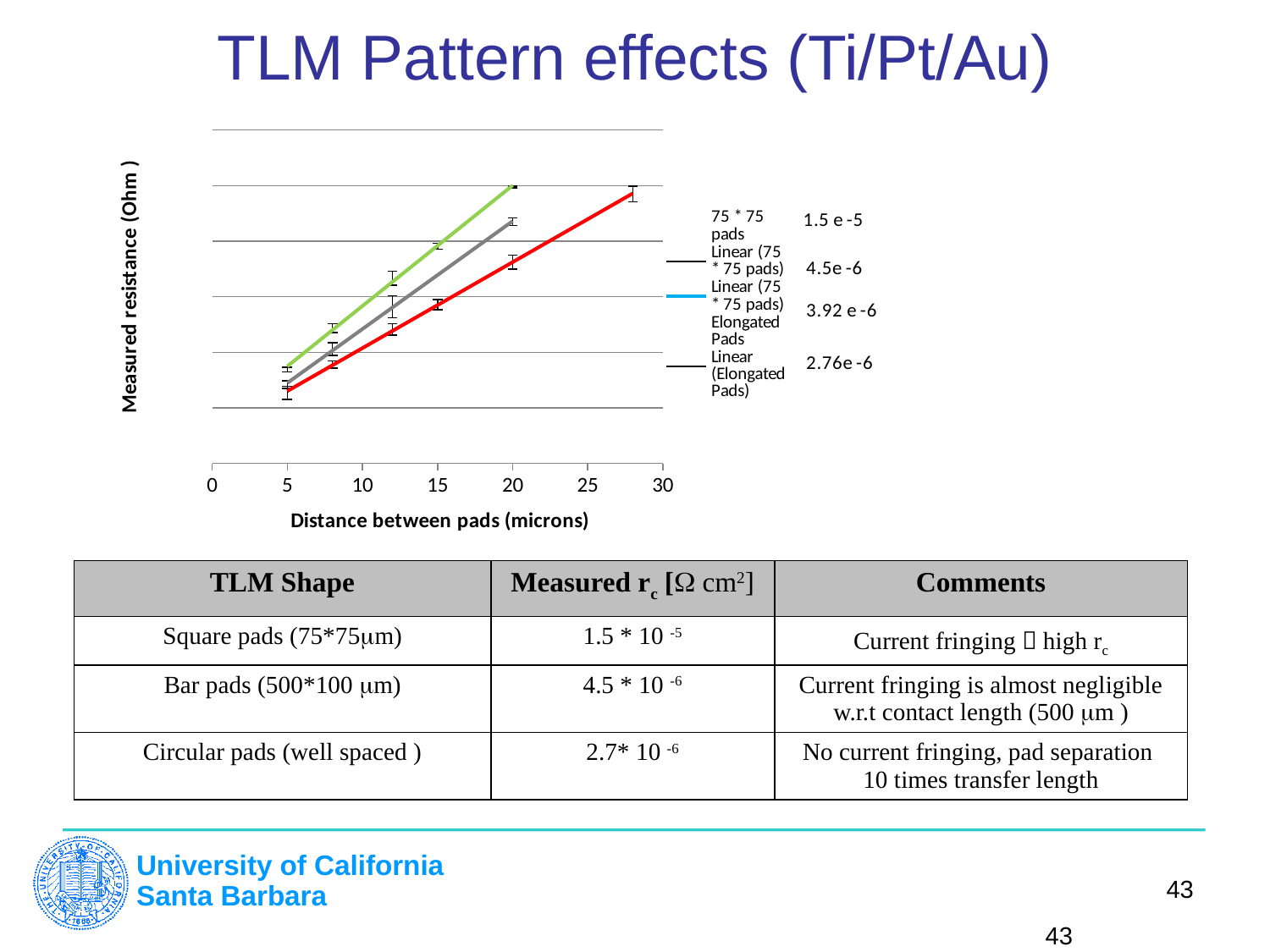
Do the measured resistance values rise or fall as the distance between pads increases? rise What value is printed beside the legend entry '75 * 75 pads'? 1.5 e -5 What is the largest tick value shown on the x axis of the chart? 30 What value is printed beside the legend entry 'Linear (Elongated Pads)'? 2.76e -6 Is the distance of the rightmost data point on the red line greater or less than 25 microns? greater What kind of chart is shown on the slide? line chart How many entries does the chart legend list? 5 How many fitted straight lines are drawn on the chart? 3 What is the label of the y axis of the chart? Measured resistance (Ohm) What is the label of the x axis of the chart? Distance between pads (microns)